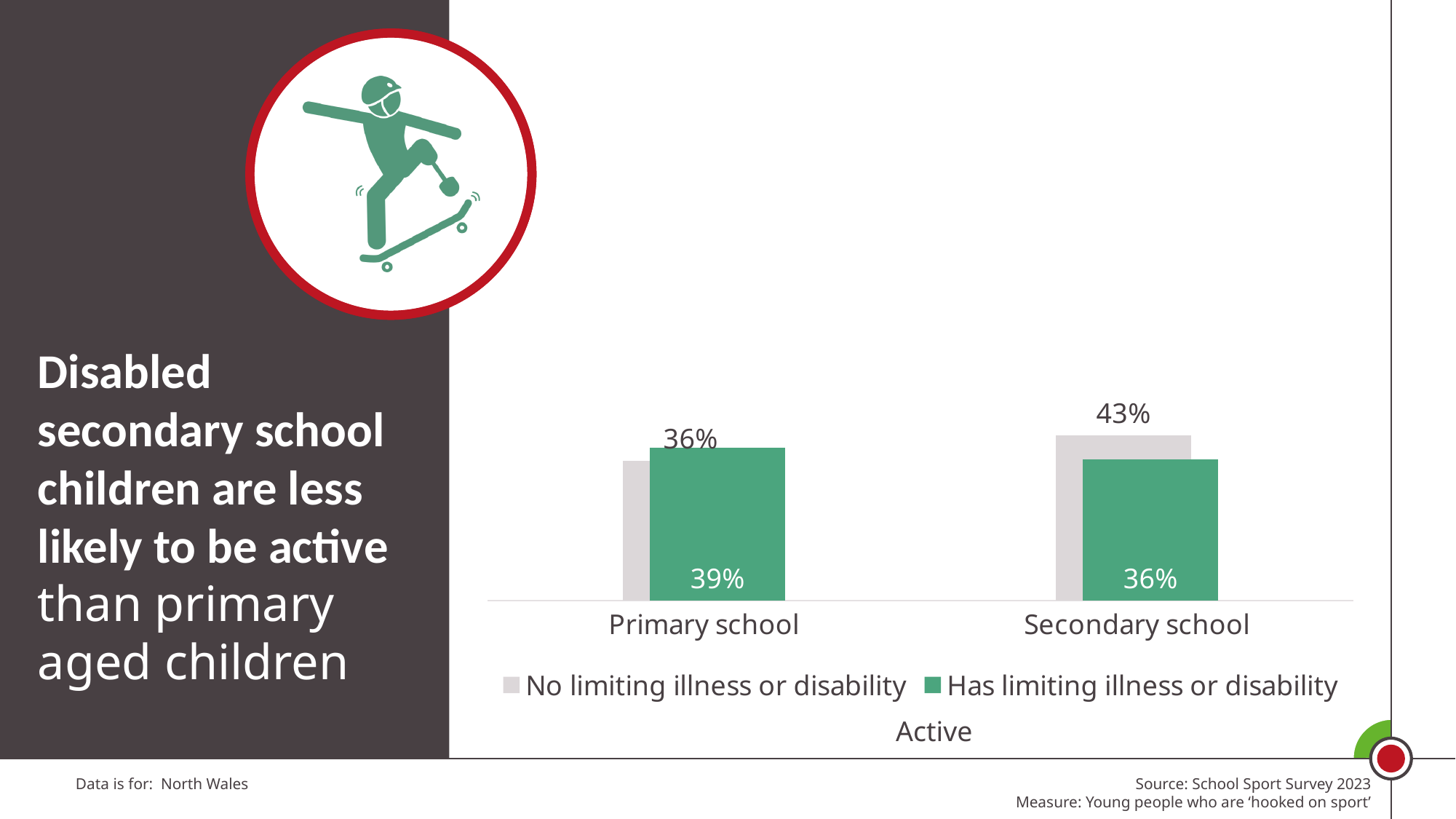
For Primary school, which is larger: the value for 'No limiting illness or disability' or the value for 'Has limiting illness or disability'? Has limiting illness or disability What is the value for 'No limiting illness or disability' for Secondary school? 43% What is the value for 'Has limiting illness or disability' for Primary school? 39% How many school categories are shown on the x axis of the chart? 2 For Secondary school, what is the difference between the 'No limiting illness or disability' value and the 'Has limiting illness or disability' value? 7% How many series does the chart legend list? 2 What is the difference between the 'Has limiting illness or disability' values for Primary school and Secondary school? 3% What colour are the bars for the 'Has limiting illness or disability' series? green Which bar in the chart has the highest value? No limiting illness or disability, Secondary school What kind of chart is shown on the slide? bar chart What is the value for 'Has limiting illness or disability' for Secondary school? 36% What is the value for 'No limiting illness or disability' for Primary school? 36%